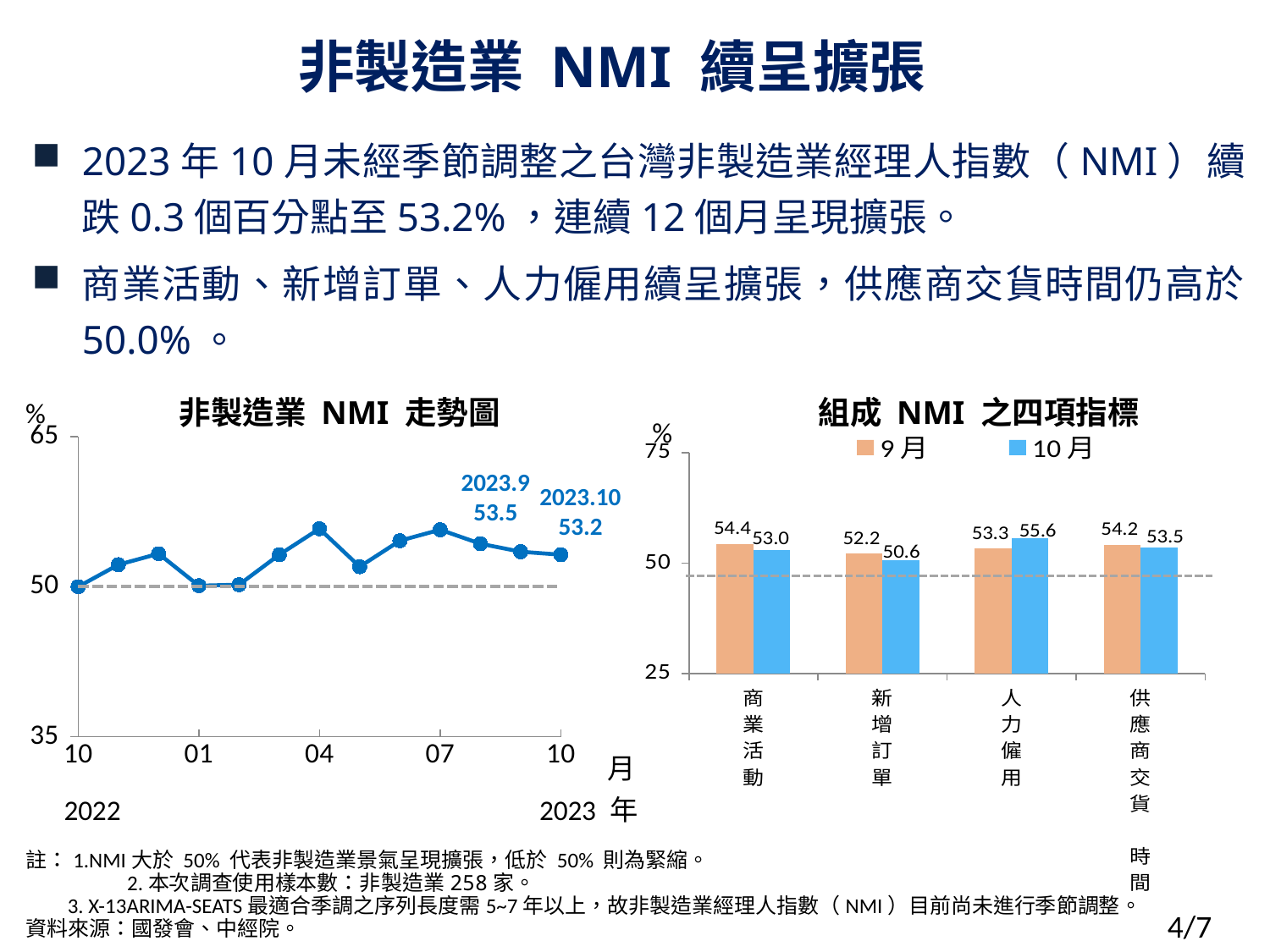
In the chart titled 非製造業 NMI 走勢圖, by how much did the NMI change from 2023.9 to 2023.10? 0.3 What kind of chart is the 非製造業 NMI 走勢圖? line chart In the chart titled 組成 NMI 之四項指標, what is the difference between the 9月 and 10月 values for 新增訂單? 1.6 In the chart titled 非製造業 NMI 走勢圖, what is the NMI value labelled for 2023.10? 53.2 In the chart titled 非製造業 NMI 走勢圖, what is the NMI value labelled for 2023.9? 53.5 In the chart titled 組成 NMI 之四項指標, which indicator has the lowest 10月 value? 新增訂單 In the chart titled 組成 NMI 之四項指標, what is the 10月 value for 人力僱用? 55.6 In the chart titled 組成 NMI 之四項指標, which indicator has the highest 10月 value? 人力僱用 In the chart titled 組成 NMI 之四項指標, what is the 9月 value for 商業活動? 54.4 In the chart titled 組成 NMI 之四項指標, is the 10月 value for 供應商交貨時間 higher or lower than its 9月 value? lower How many indicators are shown in the chart titled 組成 NMI 之四項指標? 4 How many series does the legend of the chart titled 組成 NMI 之四項指標 list? 2